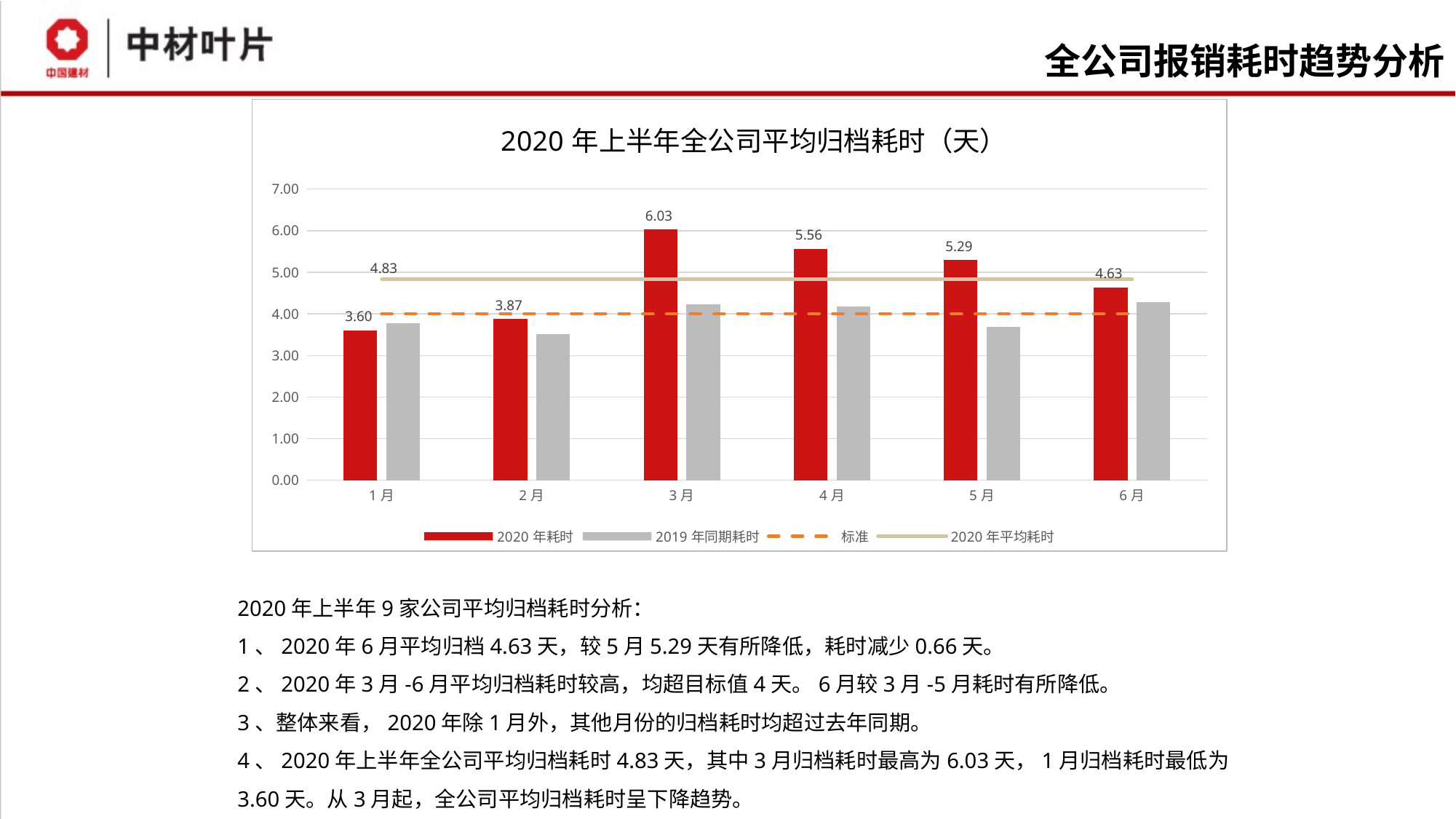
Which month has the highest 2020 年耗时 value? 3 月 How many series does the legend list? 4 What is the difference between the 2020 年耗时 values for 3 月 and 1 月? 2.43 What is the difference between the 2020 年耗时 values for 5 月 and 6 月? 0.66 Do the 2020 年耗时 values rise or fall from 3 月 to 6 月? fall How many months are shown on the x axis? 6 Which month has the larger 2020 年耗时 value, 4 月 or 5 月? 4 月 What is the 2020 年耗时 value for 6 月? 4.63 What value is shown for the 2020 年平均耗时 line? 4.83 What is the 2020 年耗时 value for 3 月? 6.03 Which month has the lowest 2020 年耗时 value? 1 月 Is the 2019 年同期耗时 value for 2 月 greater or less than 4.00? less